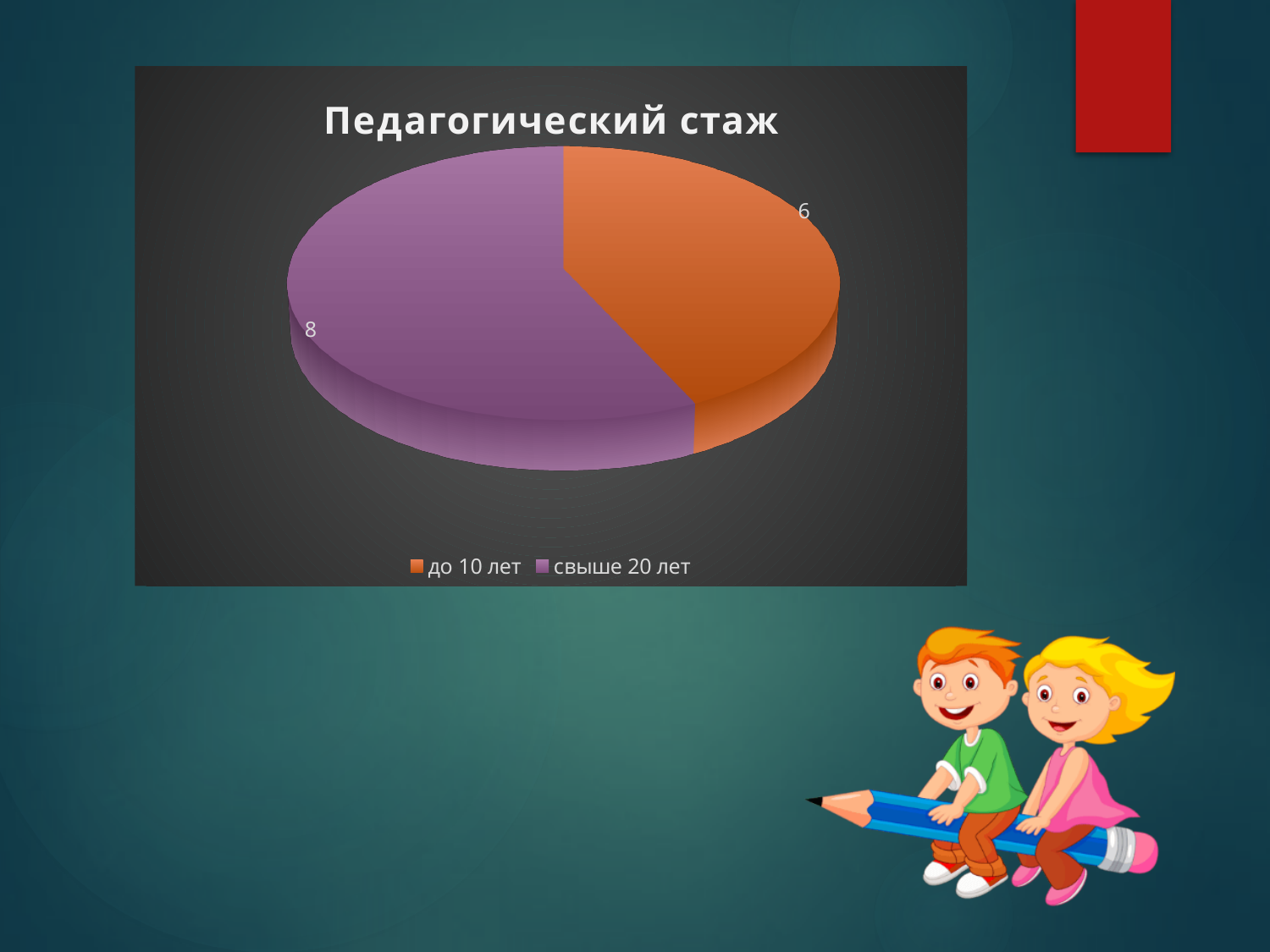
What is the title of the chart? Педагогический стаж What is the difference between the values for "свыше 20 лет" and "до 10 лет"? 2 Which category has the largest slice? свыше 20 лет What kind of chart is shown on the slide? pie chart Which is larger, the value for "до 10 лет" or for "свыше 20 лет"? свыше 20 лет What is the value for "свыше 20 лет"? 8 What colour is the slice for "до 10 лет"? orange What is the total of all slices in the pie chart? 14 What is the value for "до 10 лет"? 6 How many categories does the pie chart show? 2 Which category has the smallest slice? до 10 лет